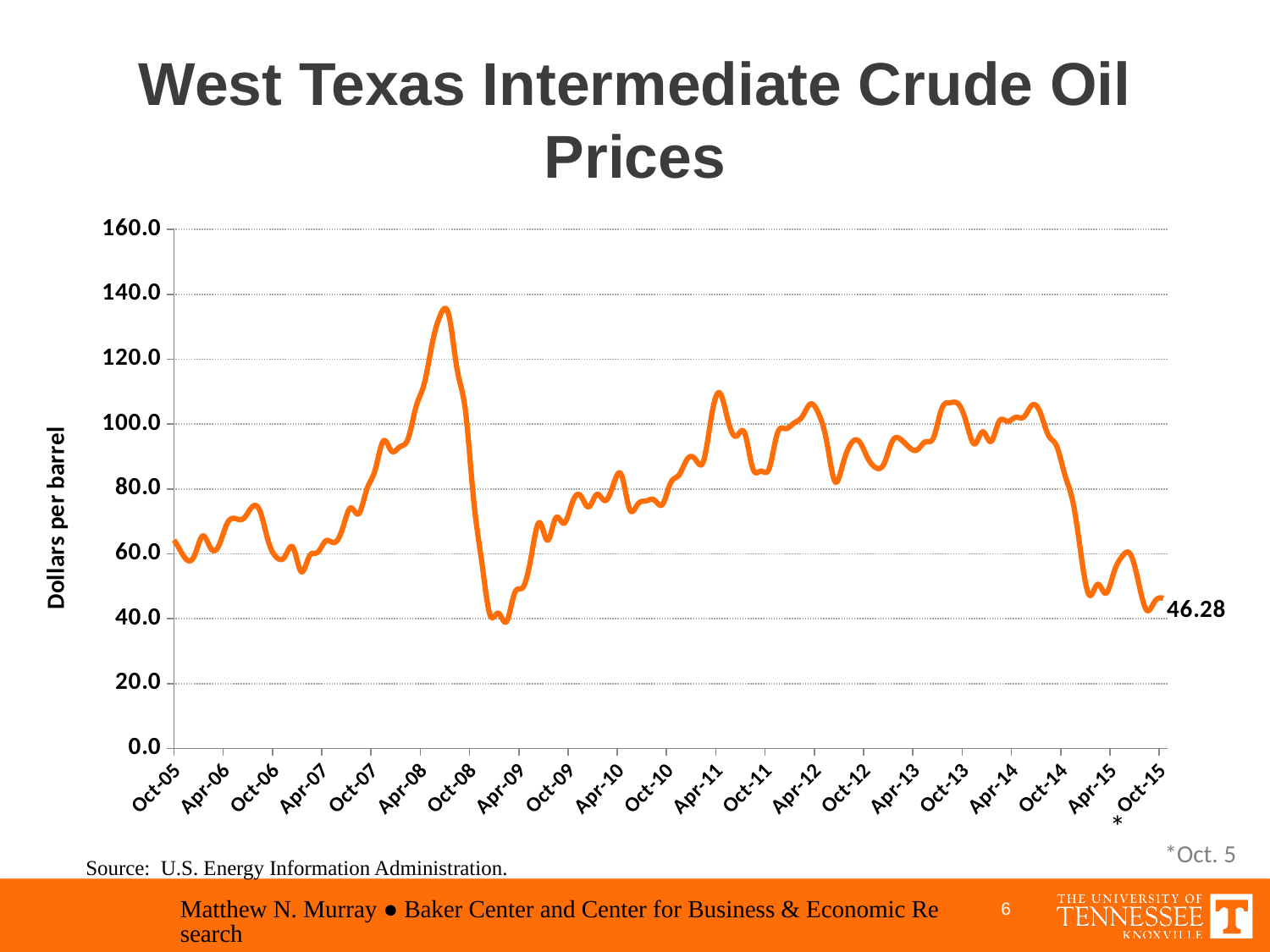
What is the title of the vertical axis? Dollars per barrel Between which two x-axis labels does the line reach its highest value? Apr-08 and Oct-08 How many date labels are shown on the x axis? 21 Which is larger, the value for Oct-05 or the value for Oct-15? Oct-05 What kind of chart is shown on the slide? line chart Is the value for Oct-05 greater or less than 80? less Is the value for Apr-09 greater or less than 60? less Is the peak value reached in mid-2008 greater or less than 120? greater What is the labeled value at the end of the line, for Oct-15? 46.28 Do the values rise or fall between Oct-14 and Apr-15? fall